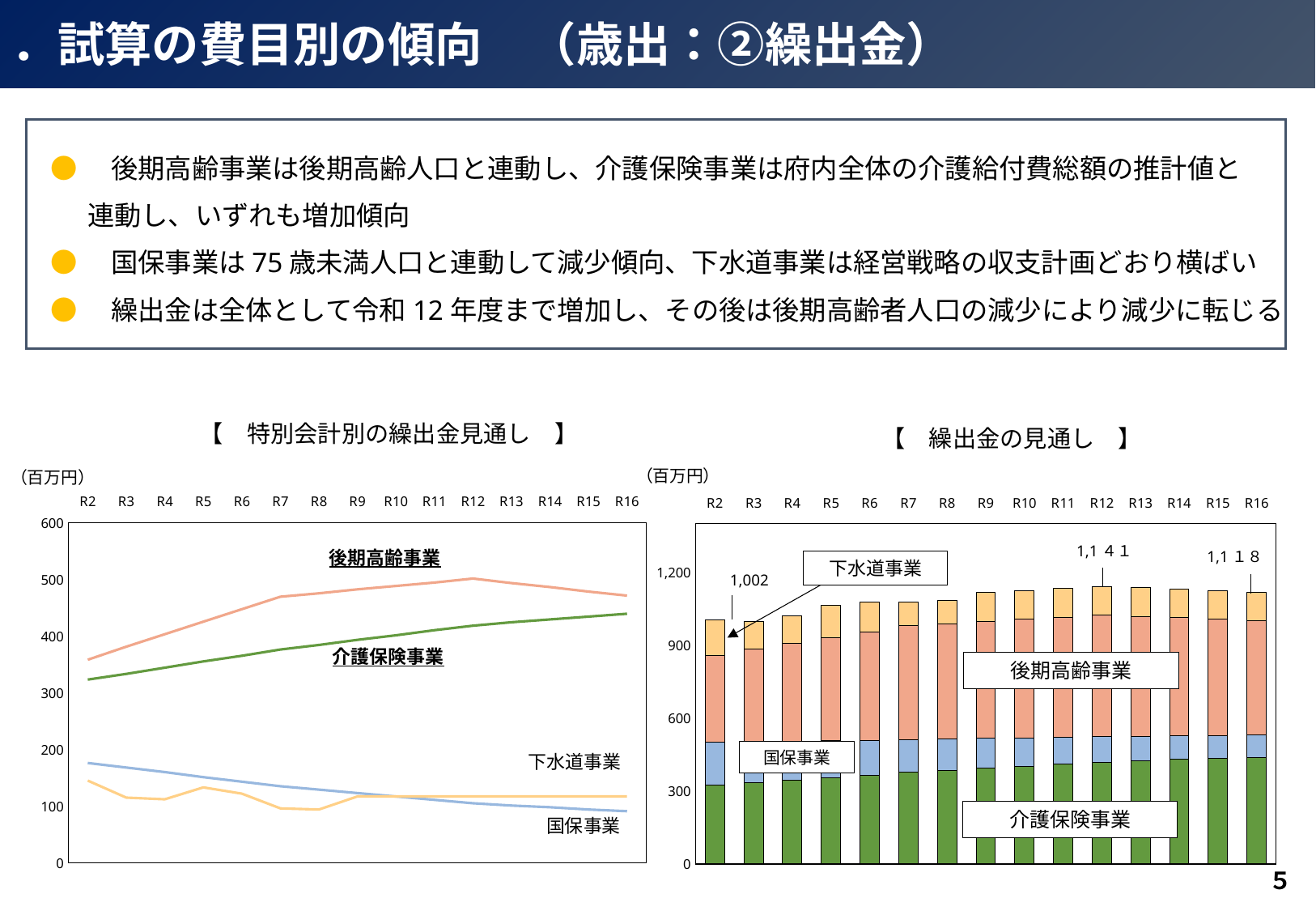
In the right chart 繰出金の見通し, what is the total value of the bar for R16? 1,118 In the right chart 繰出金の見通し, what is the difference between the labelled totals for R12 and R2? 139 In the right chart 繰出金の見通し, what is the total value of the bar for R12? 1,141 In the left chart 特別会計別の繰出金見通し, is the value for 後期高齢事業 at R12 greater or less than 400? greater In the right chart 繰出金の見通し, how many stacked segments (series) make up each bar? 4 In the right chart 繰出金の見通し, what is the total value of the bar for R2? 1,002 In the left chart 特別会計別の繰出金見通し, which series has the highest value at R2? 後期高齢事業 What kind of chart is the left chart titled 特別会計別の繰出金見通し? line chart In the left chart 特別会計別の繰出金見通し, how many years are shown on the x axis? 15 In the left chart 特別会計別の繰出金見通し, does the 国保事業 line rise or fall from R2 to R16? fall In the right chart 繰出金の見通し, which bar has the larger labelled total, R12 or R16? R12 What kind of chart is the right chart titled 繰出金の見通し? stacked bar chart